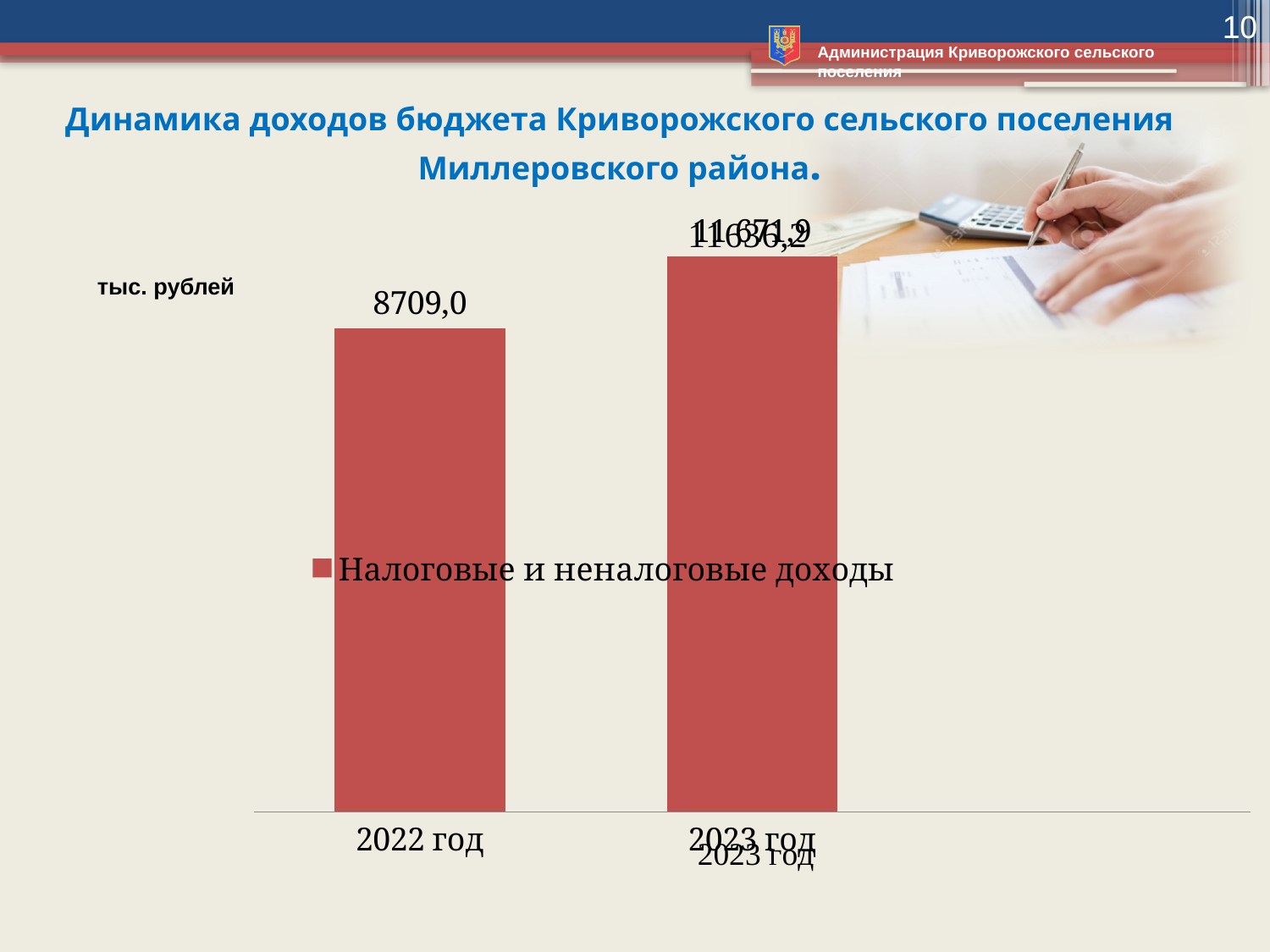
How many categories (years) are shown on the chart? 2 What series name is shown in the chart legend? Налоговые и неналоговые доходы Which year has the lowest value? 2022 год What kind of chart is shown on the slide? bar chart What is the value for 2022 год? 8709,0 In what units are the chart values given, according to the label on the slide? тыс. рублей Do the values rise or fall from 2022 год to 2023 год? rise How many series does the legend list? 1 Which is larger, the value for 2022 год or for 2023 год? 2023 год Which year has the highest value? 2023 год